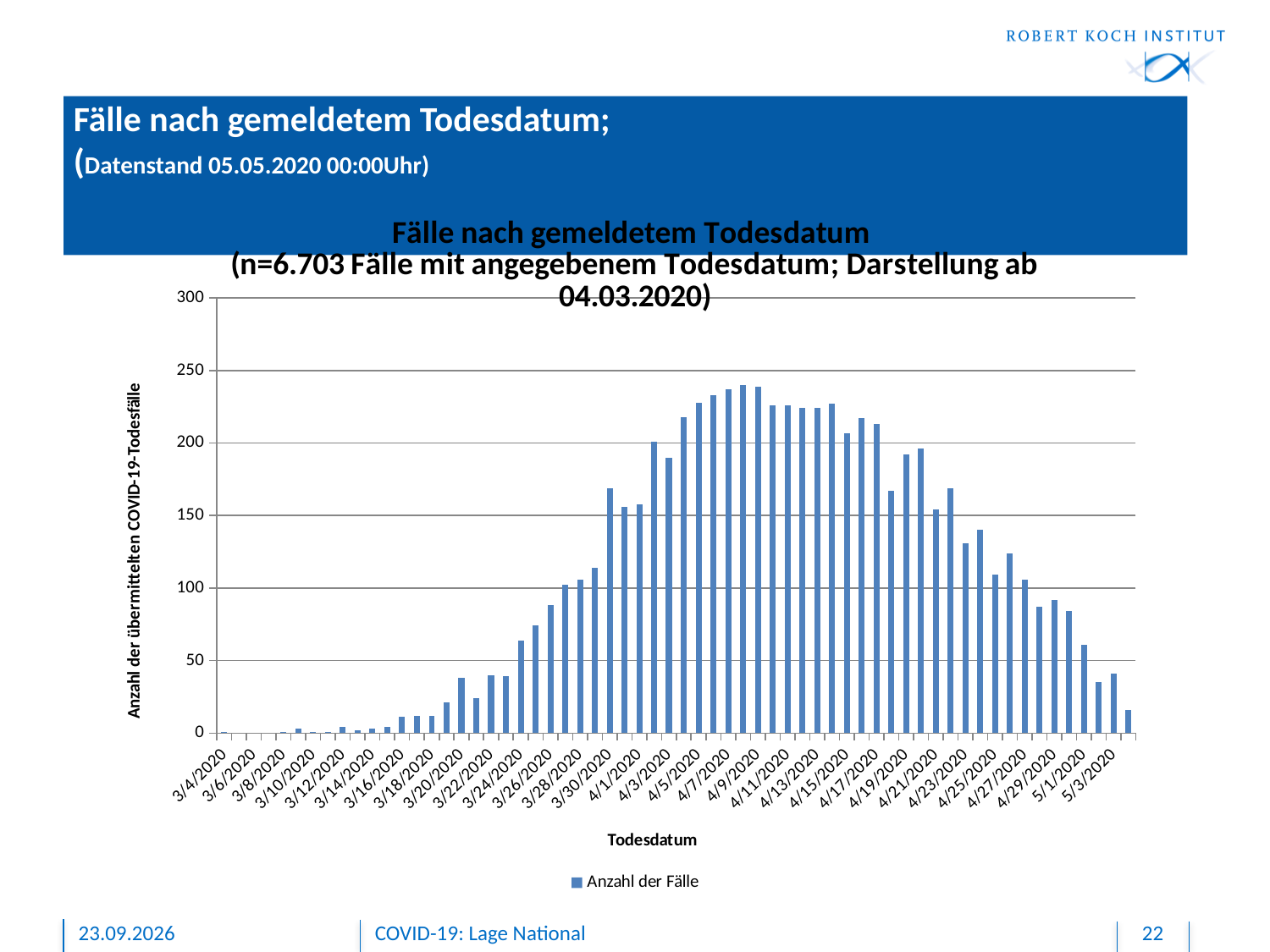
Is the value for 4/29/2020 greater or less than 100? less Which has the larger value, 3/10/2020 or 4/1/2020? 4/1/2020 Is the value for 3/22/2020 greater or less than 50? less Is the value for 3/4/2020 greater or less than 50? less Which has the larger value, 4/9/2020 or 5/3/2020? 4/9/2020 What is the legend entry for the plotted series? Anzahl der Fälle Do the values generally rise or fall from 4/9/2020 to 5/3/2020? fall How many series does the legend list? 1 What kind of chart is shown on the slide? bar chart What is the title of the x axis? Todesdatum